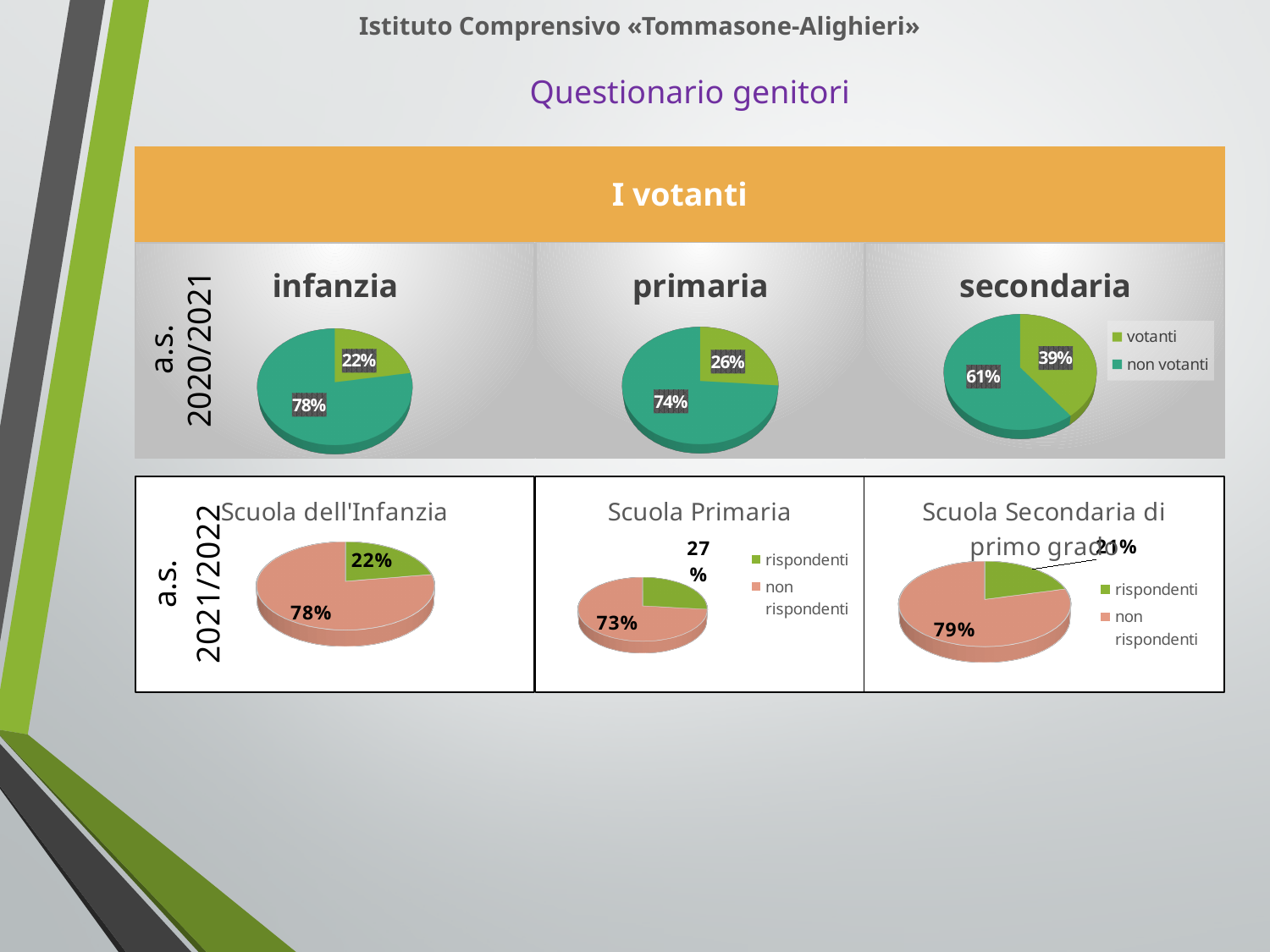
In the 2020/2021 'secondaria' pie chart, what percentage is shown for votanti? 39% In the 2020/2021 'primaria' pie chart, what percentage is shown for non votanti? 74% In the 2021/2022 'Scuola dell'Infanzia' pie chart, which slice is larger, rispondenti or non rispondenti? non rispondenti What is the difference between the votanti percentage in the 2020/2021 'secondaria' chart and the 2020/2021 'infanzia' chart? 17% Among the three 2021/2022 pie charts, which school has the lowest rispondenti percentage? Scuola Secondaria di primo grado How many entries does the legend of the 2021/2022 'Scuola Primaria' chart list? 2 In the 2020/2021 'infanzia' pie chart, what percentage is shown for votanti? 22% In the 2021/2022 'Scuola Secondaria di primo grado' pie chart, what percentage is shown for non rispondenti? 79% What are the two legend entries shown for the 2020/2021 pie charts? votanti, non votanti In the 2021/2022 'Scuola Primaria' pie chart, what percentage is shown for rispondenti? 27% Among the three 2020/2021 pie charts, which school level has the highest votanti percentage? secondaria What type of chart is used for the 2020/2021 'primaria' data? pie chart